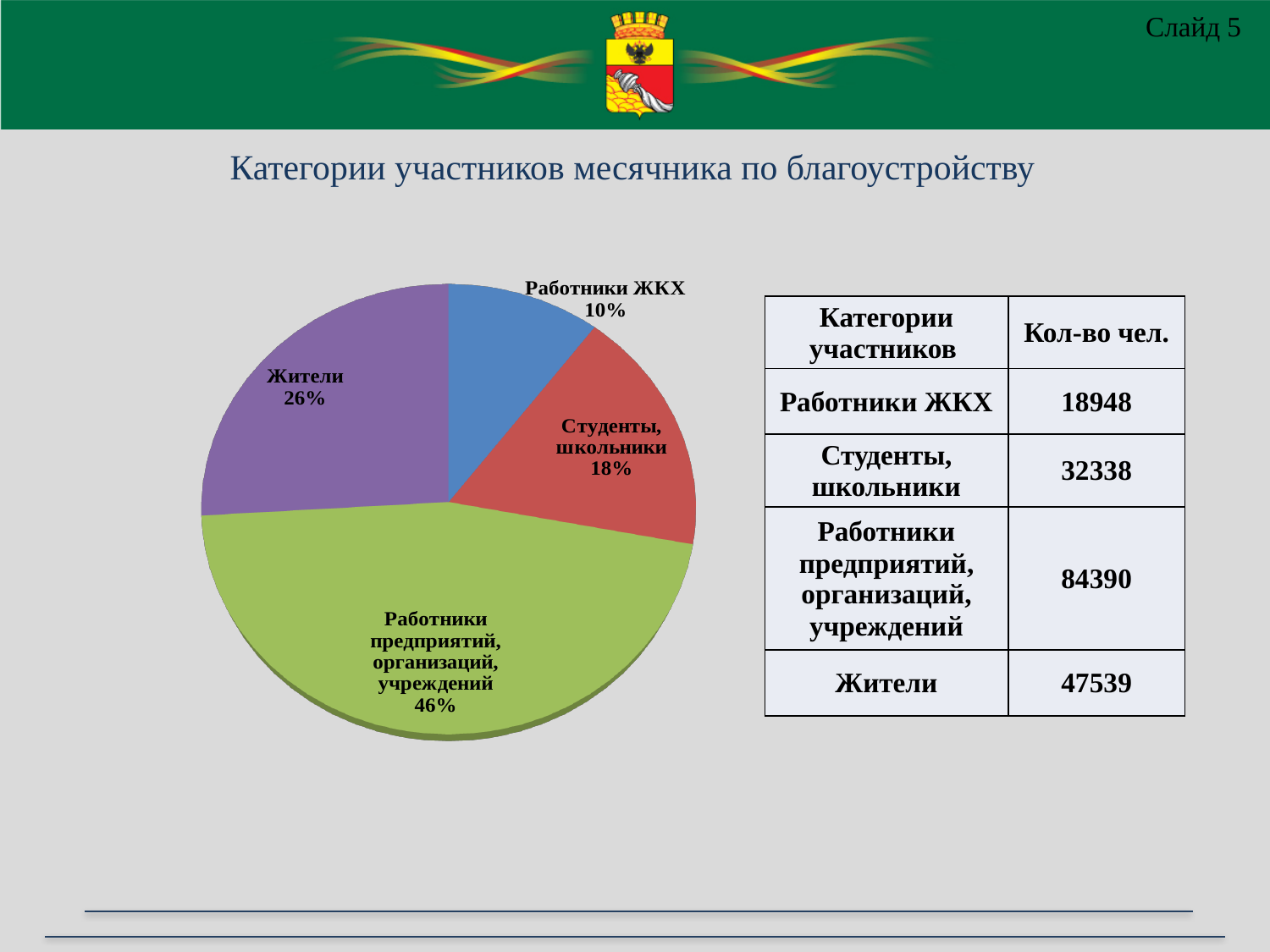
Which slice is larger: Жители or Студенты, школьники? Жители What share of the pie does Работники предприятий, организаций, учреждений have? 46% What colour is the Жители slice of the pie? purple Which category has the smallest slice of the pie? Работники ЖКХ What share of the pie does Студенты, школьники have? 18% How many slices does the pie chart have? 4 What is the title of the chart on the slide? Категории участников месячника по благоустройству Which category has the largest slice of the pie? Работники предприятий, организаций, учреждений What kind of chart is shown on the slide? pie chart What share of the pie does Работники ЖКХ have? 10% What is the difference in percentage points between the Жители slice and the Работники ЖКХ slice? 16